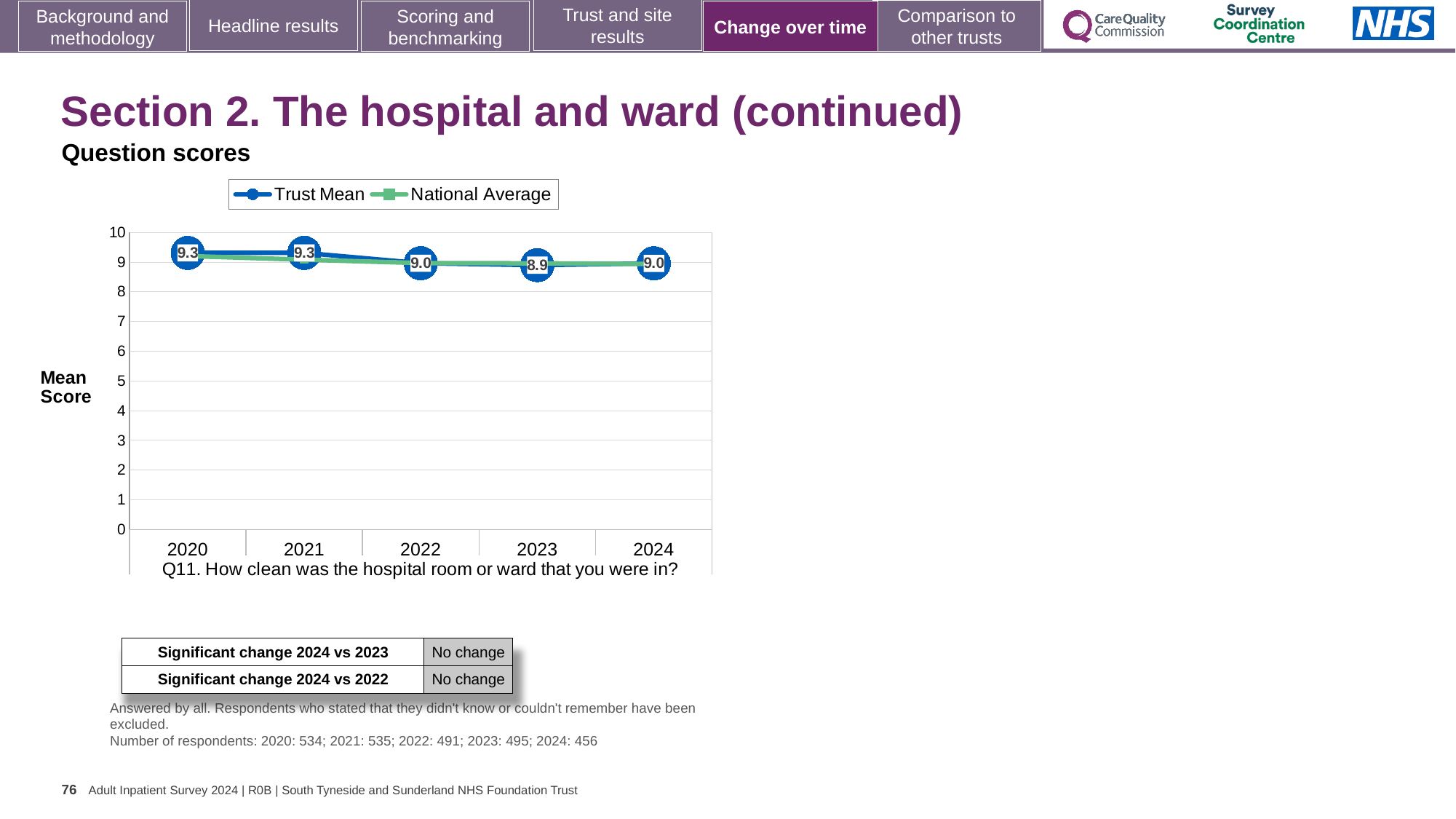
Is the National Average value for 2022 greater or less than 8? greater What is the difference between the Trust Mean score in 2021 and in 2023? 0.4 How many series does the chart legend list? 2 What is the Trust Mean score for 2023? 8.9 What is the Trust Mean score for 2024? 9.0 What is the Trust Mean score for 2020? 9.3 Does the Trust Mean score rise or fall from 2021 to 2023? Fall What kind of chart is shown on the slide? Line chart How many years are shown on the x axis of the chart? 5 Is the Trust Mean score for 2020 larger than the Trust Mean score for 2024? Yes, 2020 (9.3) is larger than 2024 (9.0) What is the Trust Mean score for 2022? 9.0 In which year is the Trust Mean score lowest? 2023